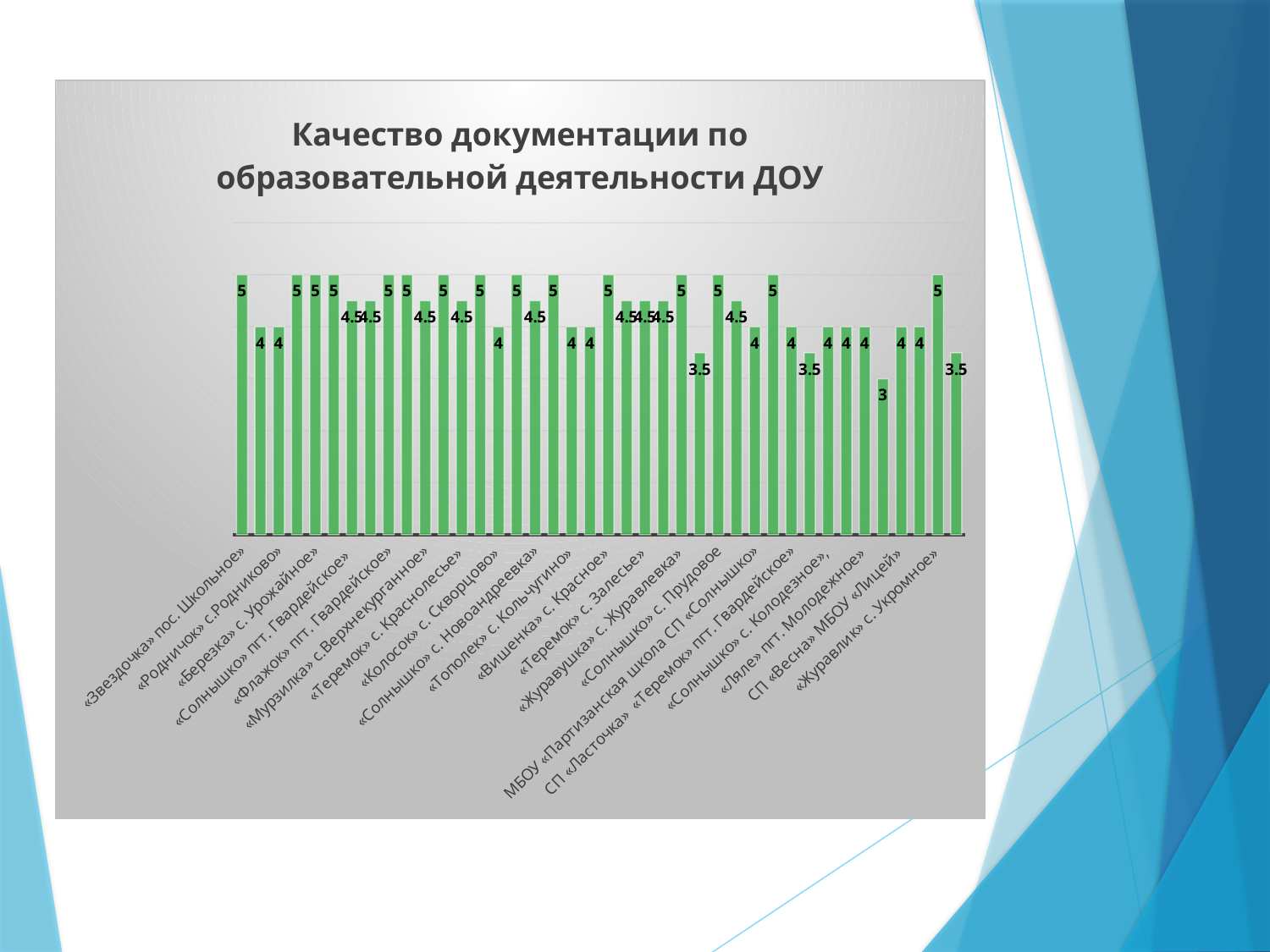
How many bars have a value of 3.5? 3 How many bars have a value of 3? 1 What is the lowest value shown on the chart? 3 Is the value for «Звездочка» пос. Школьное greater or less than 4? greater Which is larger, the value of the first bar (5) or the value of the last bar (3.5)? the first bar (5) How many bars are plotted on the chart? 40 What is the value for «Звездочка» пос. Школьное? 5 What is the highest value shown on the chart? 5 What is the difference between the highest value (5) and the lowest value (3) on the chart? 2 What colour are the bars on the chart? green What kind of chart is shown on the slide? bar chart What is the title of the chart? Качество документации по образовательной деятельности ДОУ